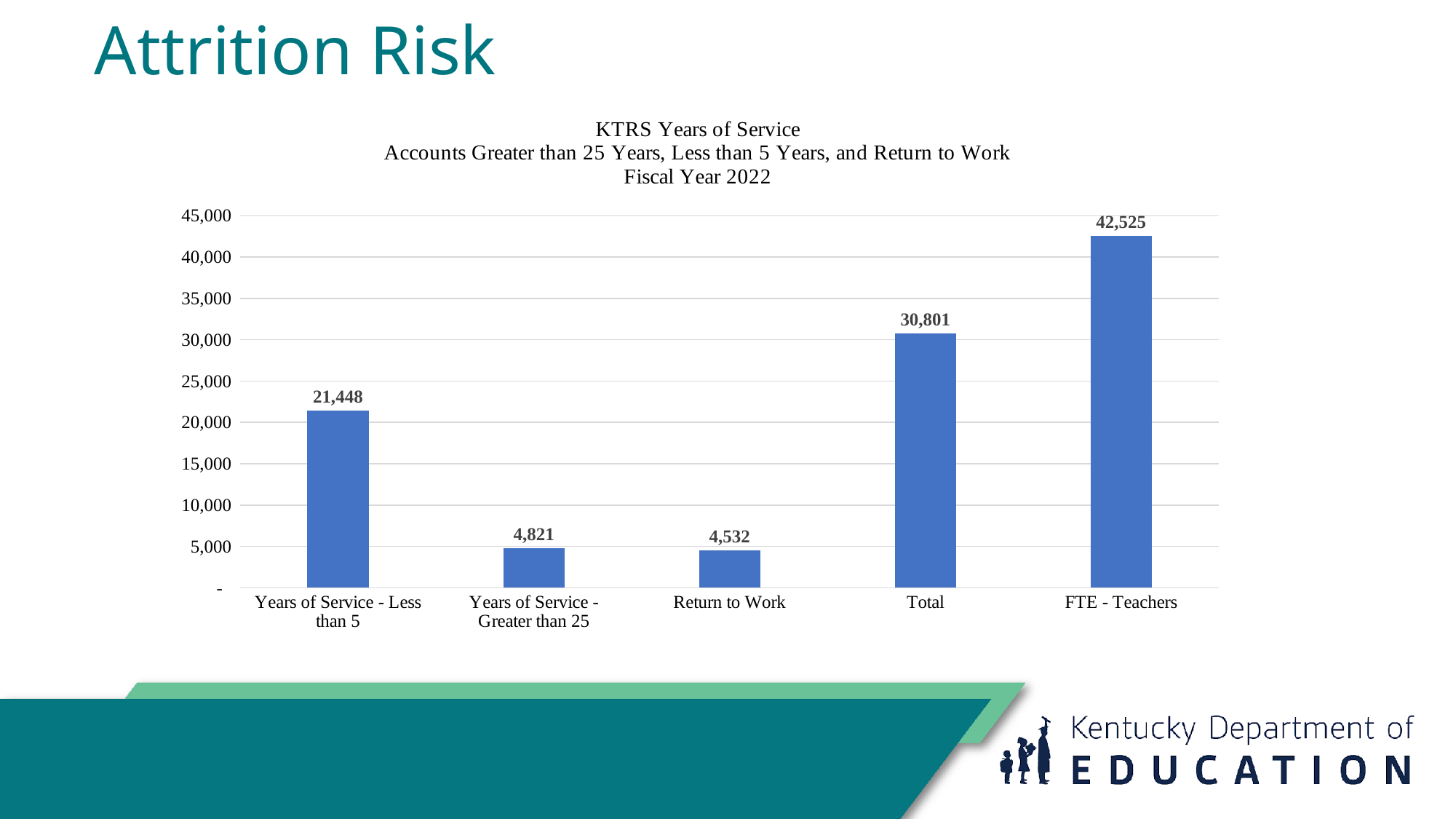
What kind of chart is shown on the slide? bar chart What is the value for FTE - Teachers? 42,525 What is the value for Return to Work? 4,532 How many categories are shown on the x axis? 5 What is the value for Years of Service - Less than 5? 21,448 Which category has the lowest value? Return to Work Which is larger, Years of Service - Less than 5 or Total? Total What is the difference between Years of Service - Greater than 25 and Return to Work? 289 What is the difference between the Total bar and the FTE - Teachers bar? 11,724 Which category has the highest value? FTE - Teachers Is the value for Years of Service - Less than 5 greater or less than 20,000? greater Which fiscal year does the chart title say the data is for? Fiscal Year 2022